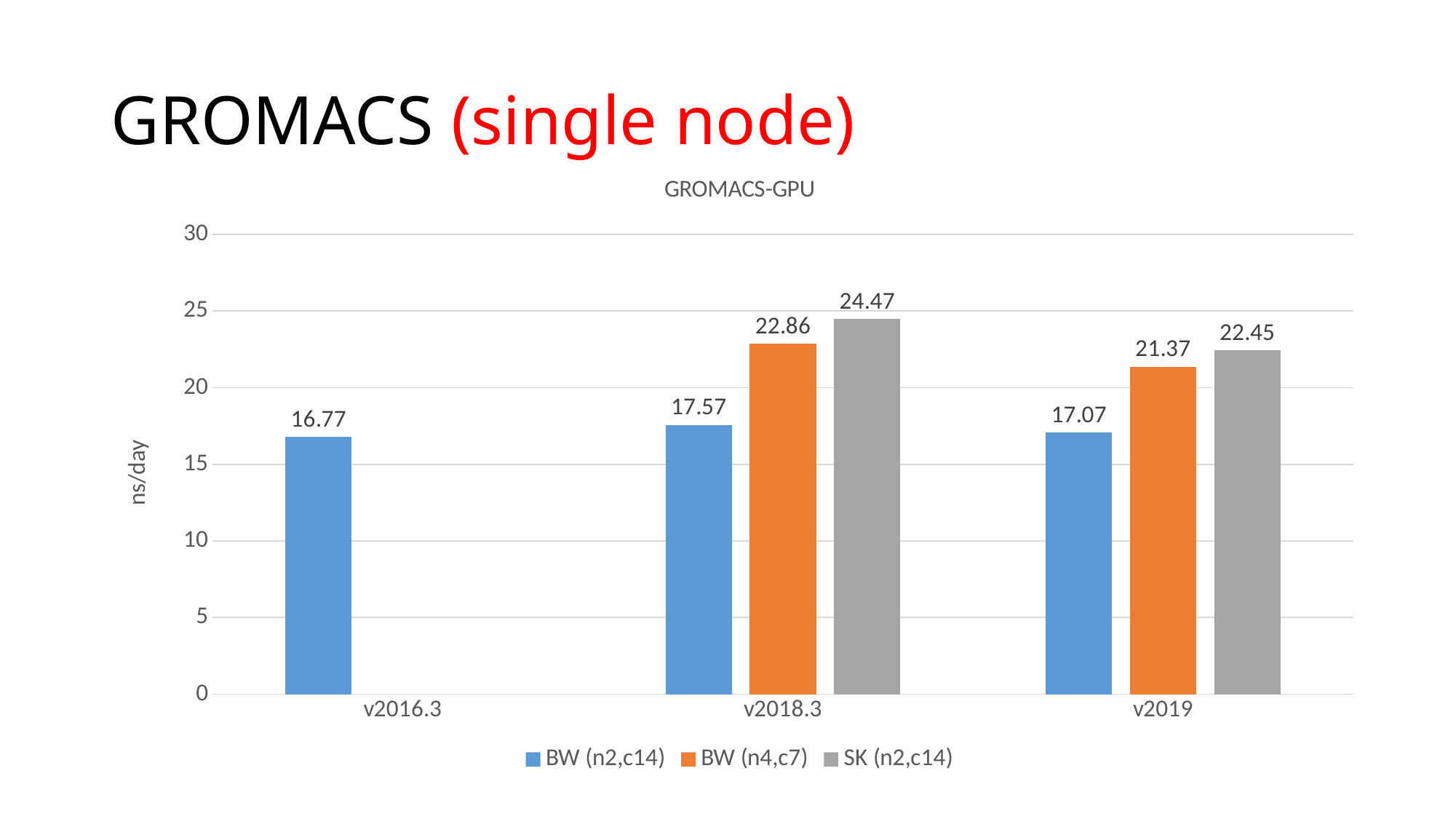
What is the value for SK (n2,c14) at v2018.3? 24.47 How many series does the legend list? 3 Which is larger: BW (n2,c14) at v2018.3 or BW (n2,c14) at v2019? BW (n2,c14) at v2018.3 What is the difference between SK (n2,c14) and BW (n4,c7) at v2018.3? 1.61 What is the title of the chart? GROMACS-GPU What kind of chart is shown? bar chart Which series has the lowest value at v2019? BW (n2,c14) What is the value for BW (n4,c7) at v2019? 21.37 What is the value for BW (n2,c14) at v2016.3? 16.77 Which series has the highest value at v2018.3? SK (n2,c14) Is the value for SK (n2,c14) at v2019 greater or less than 20? greater How many version categories are shown on the x axis? 3